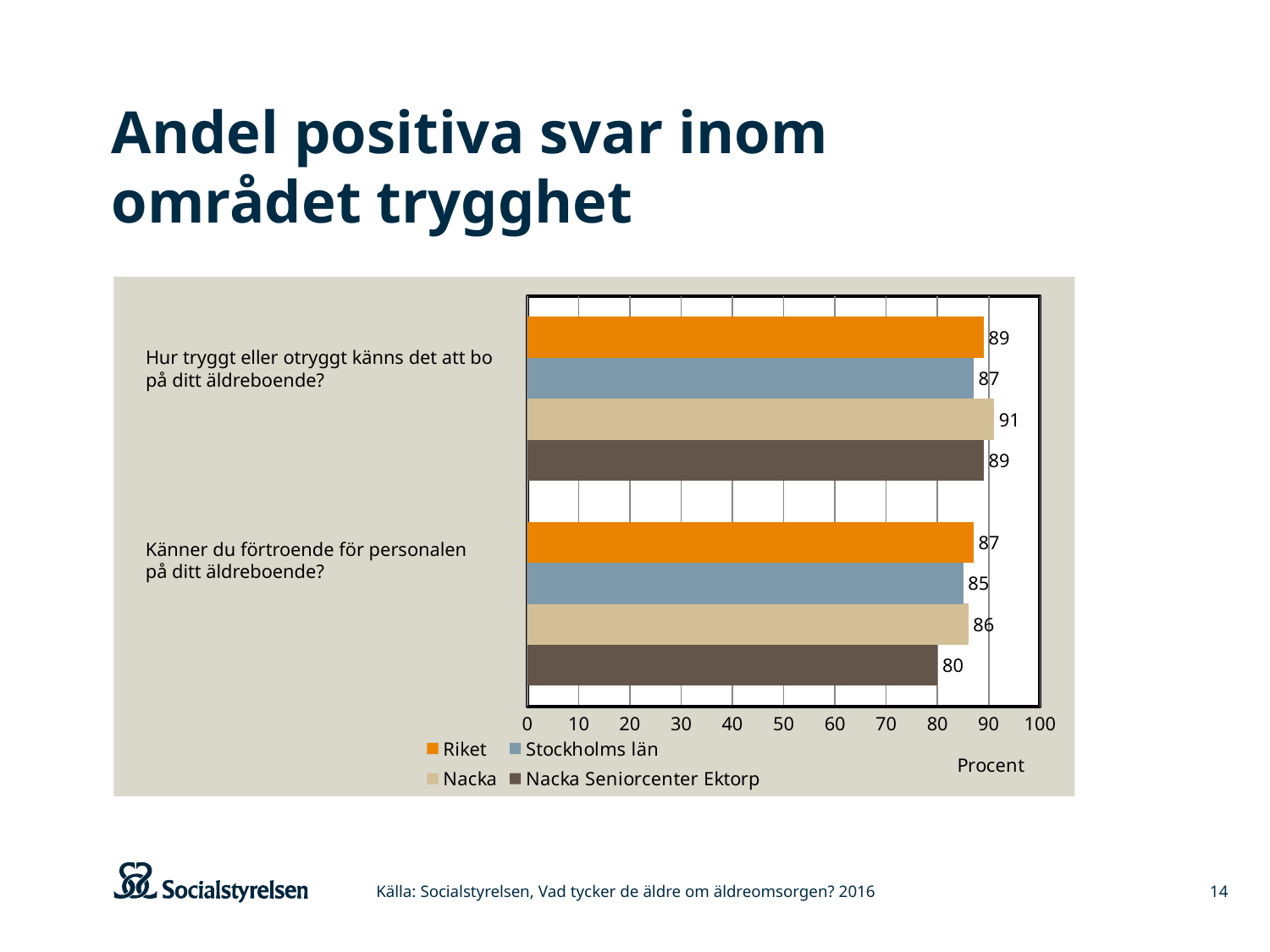
What is the value for Riket for the question 'Hur tryggt eller otryggt känns det att bo på ditt äldreboende?' 89 What is the label of the horizontal axis? Procent What is the value for Nacka Seniorcenter Ektorp for the question 'Känner du förtroende för personalen på ditt äldreboende?' 80 How many series does the legend list? 4 What is the difference between the Nacka value and the Nacka Seniorcenter Ektorp value for the question 'Känner du förtroende för personalen på ditt äldreboende?' 6 What is the value for Stockholms län for the question 'Känner du förtroende för personalen på ditt äldreboende?' 85 What kind of chart is shown on the slide? Bar chart What is the value for Nacka for the question 'Hur tryggt eller otryggt känns det att bo på ditt äldreboende?' 91 Which series has the highest value for the question 'Hur tryggt eller otryggt känns det att bo på ditt äldreboende?' Nacka Which series has the lowest value for the question 'Känner du förtroende för personalen på ditt äldreboende?' Nacka Seniorcenter Ektorp For Nacka Seniorcenter Ektorp, which question has the larger value: 'Hur tryggt eller otryggt känns det att bo på ditt äldreboende?' or 'Känner du förtroende för personalen på ditt äldreboende?' Hur tryggt eller otryggt känns det att bo på ditt äldreboende? How many questions (categories) are shown on the chart? 2